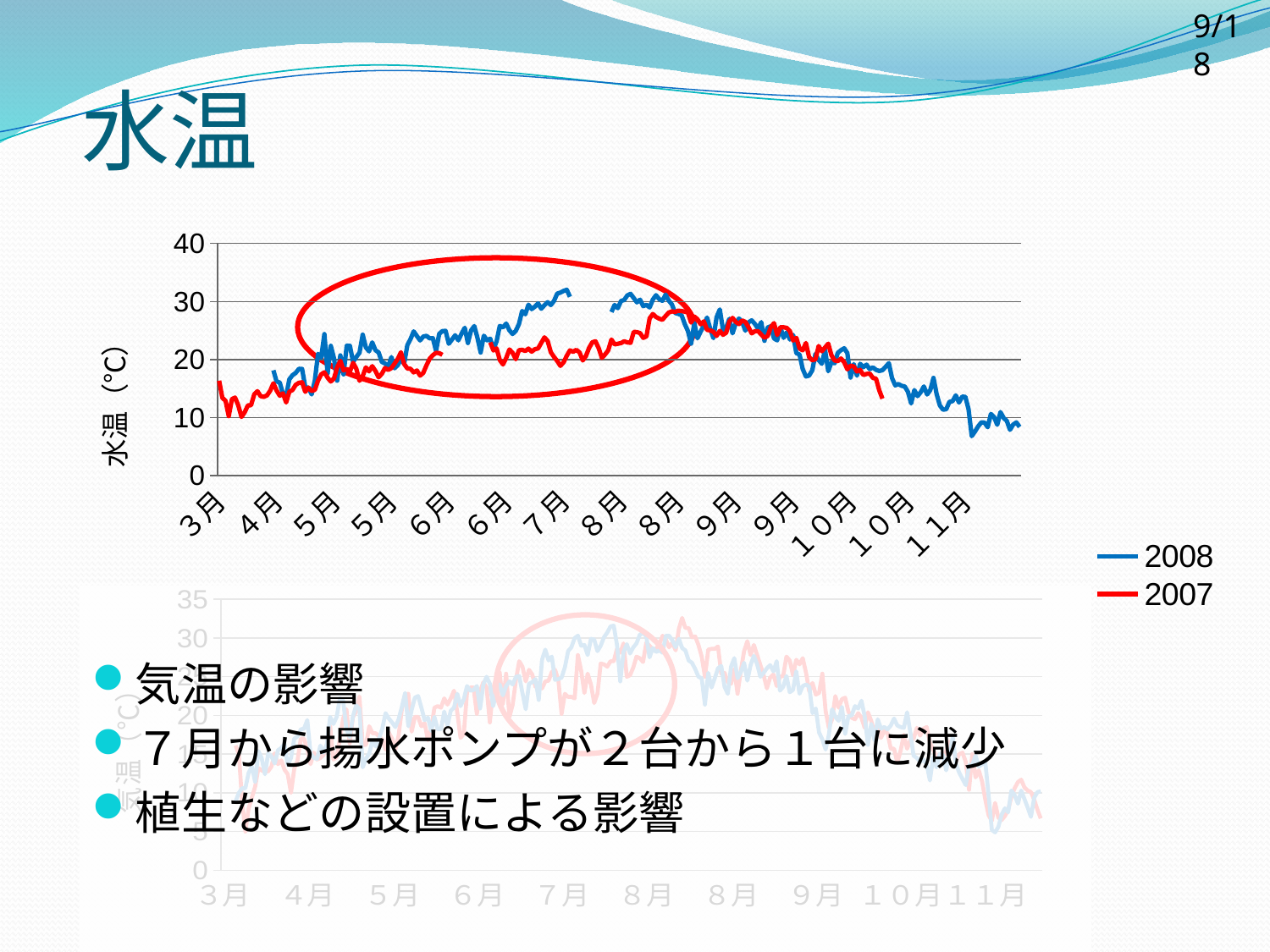
In the top chart, do the 2008 values rise or fall from 9月 to 11月? fall Which two years are listed in the legend of the top chart? 2008 and 2007 In the top chart, is the value of the 2008 series at the end of 11月 greater or less than 20? less How many series does the legend of the top chart list? 2 What is the highest value shown on the vertical axis of the top chart? 40 What is the label on the vertical axis of the top chart? 水温（℃） In the top chart, is the value of the 2007 series at the start of 3月 greater or less than 20? less In the top chart, which series has the higher values around 6月, 2008 or 2007? 2008 What kind of chart is the top chart on the slide? line chart In the top chart, do the 2008 values rise or fall from 4月 to 7月? rise In the top chart, which series extends later into the year, 2008 or 2007? 2008 In the top chart, is the peak value of the 2008 series around 7月 greater or less than 30? greater